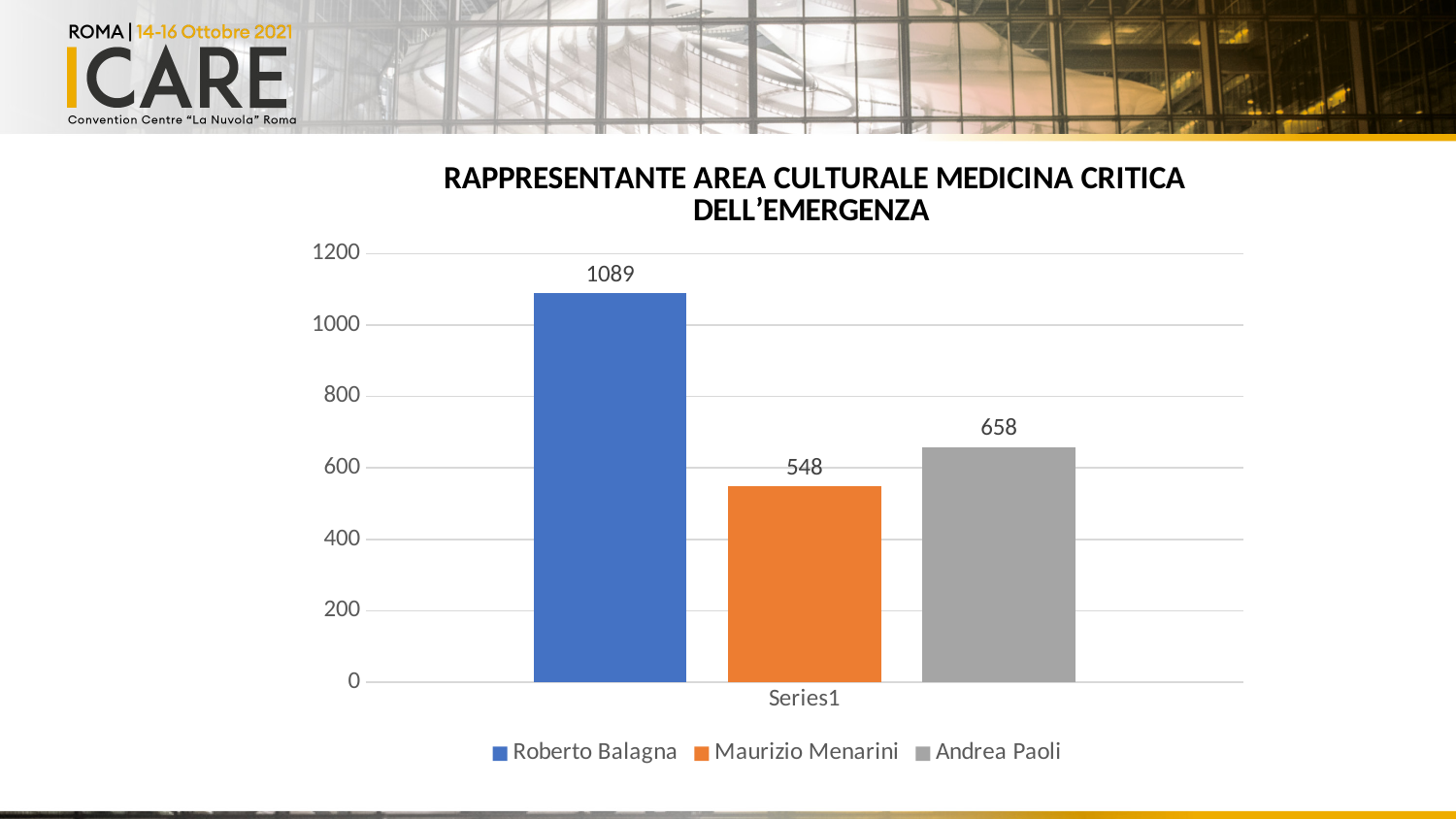
Which candidate has the highest value? Roberto Balagna What is the value for Roberto Balagna? 1089 How many series does the legend list? 3 What is the value for Maurizio Menarini? 548 What kind of chart is shown on the slide? bar chart What is the difference between the values for Andrea Paoli and Maurizio Menarini? 110 What is the value for Andrea Paoli? 658 Is the value for Roberto Balagna greater or less than 1000? greater Which candidate has the lowest value? Maurizio Menarini What is the difference between the values for Roberto Balagna and Andrea Paoli? 431 What is the title of the chart? RAPPRESENTANTE AREA CULTURALE MEDICINA CRITICA DELL'EMERGENZA Which is larger, the value for Andrea Paoli or the value for Maurizio Menarini? Andrea Paoli